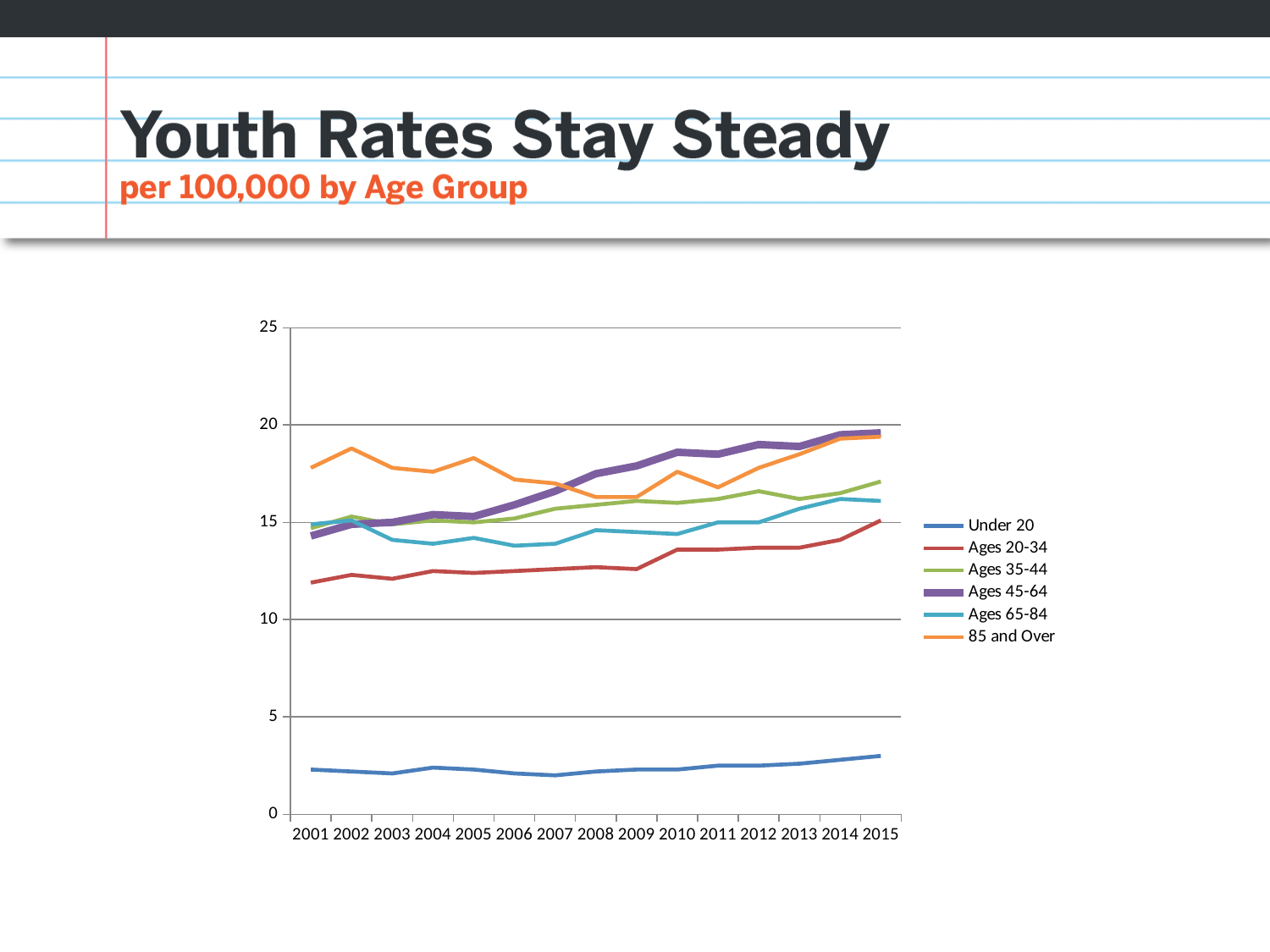
Which age group has the lowest values across all years? Under 20 What is the title of the slide? Youth Rates Stay Steady How many years are shown along the x axis? 15 Which age group has the highest value in 2002? 85 and Over What kind of chart is shown on the slide? line chart Is the value for Ages 35-44 in 2015 greater or less than 15? greater Is the value for Ages 20-34 in 2001 greater or less than 10? greater Does the value for Ages 45-64 rise or fall from 2001 to 2015? rise How many series does the legend list? 6 In 2015, which is larger: the value for Ages 20-34 or the value for Ages 35-44? Ages 35-44 Is the value for Under 20 in 2015 greater or less than 5? less